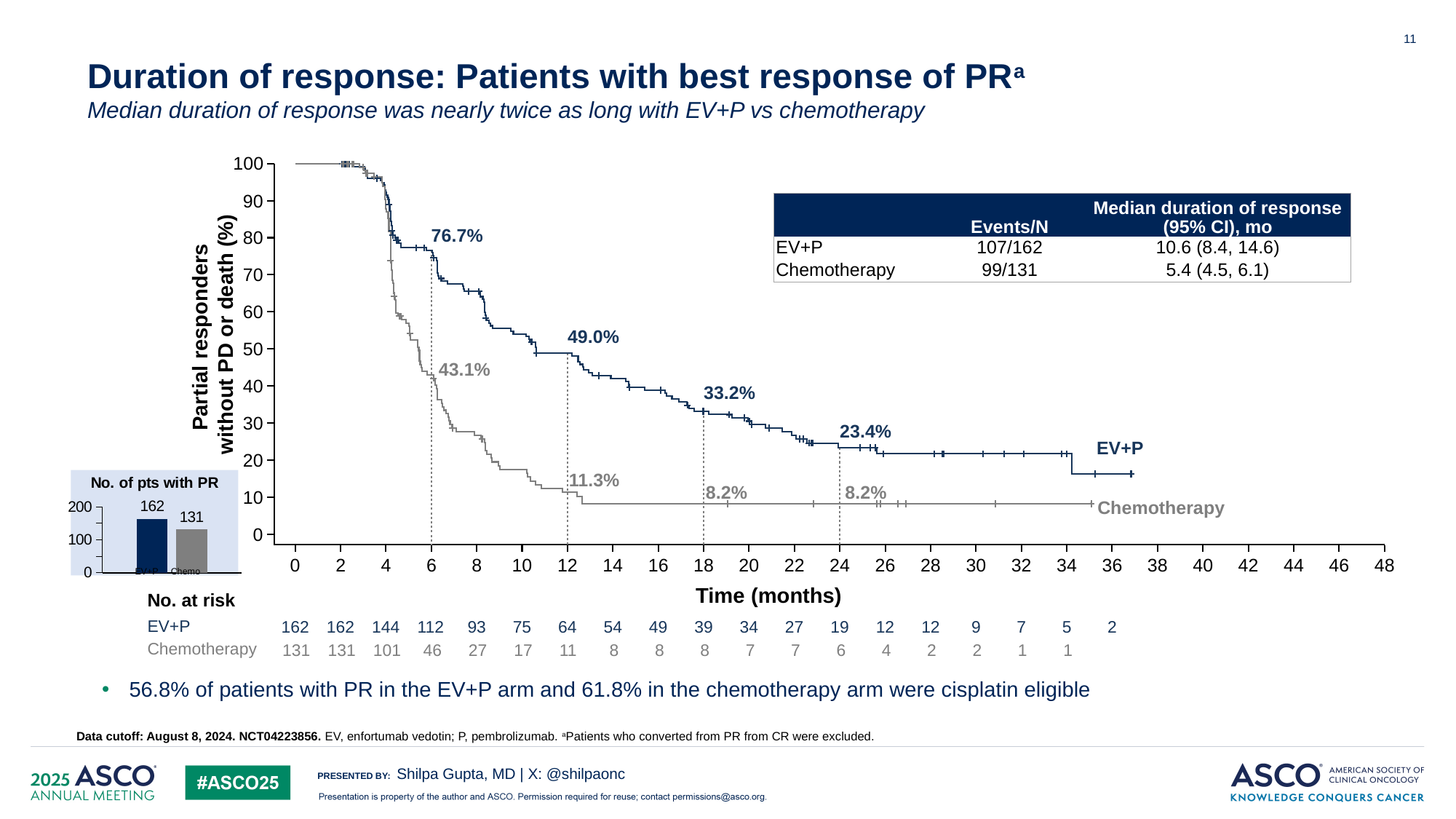
In the duration of response chart, is the Chemotherapy value at 30 months greater or less than 10? less In the duration of response chart, what is the labelled value for EV+P at 24 months? 23.4% In the duration of response chart, does the EV+P curve rise or fall as time increases? Fall What kind of chart is the main duration of response chart? Line chart (Kaplan-Meier curve) In the small 'No. of pts with PR' bar chart, which arm has the higher number of patients? EV+P In the duration of response chart, what is the labelled value for Chemotherapy at 6 months? 43.1% In the small 'No. of pts with PR' bar chart, what is the difference between the EV+P and Chemo values? 31 In the duration of response chart, what is the difference between the EV+P and Chemotherapy labelled values at 6 months? 33.6 percentage points How many arms (series) are plotted in the duration of response chart? 2 In the small 'No. of pts with PR' bar chart, what is the value for EV+P? 162 In the duration of response chart, which arm has the higher labelled value at 18 months, EV+P or Chemotherapy? EV+P In the duration of response chart, what is the labelled value for EV+P at 12 months? 49.0%